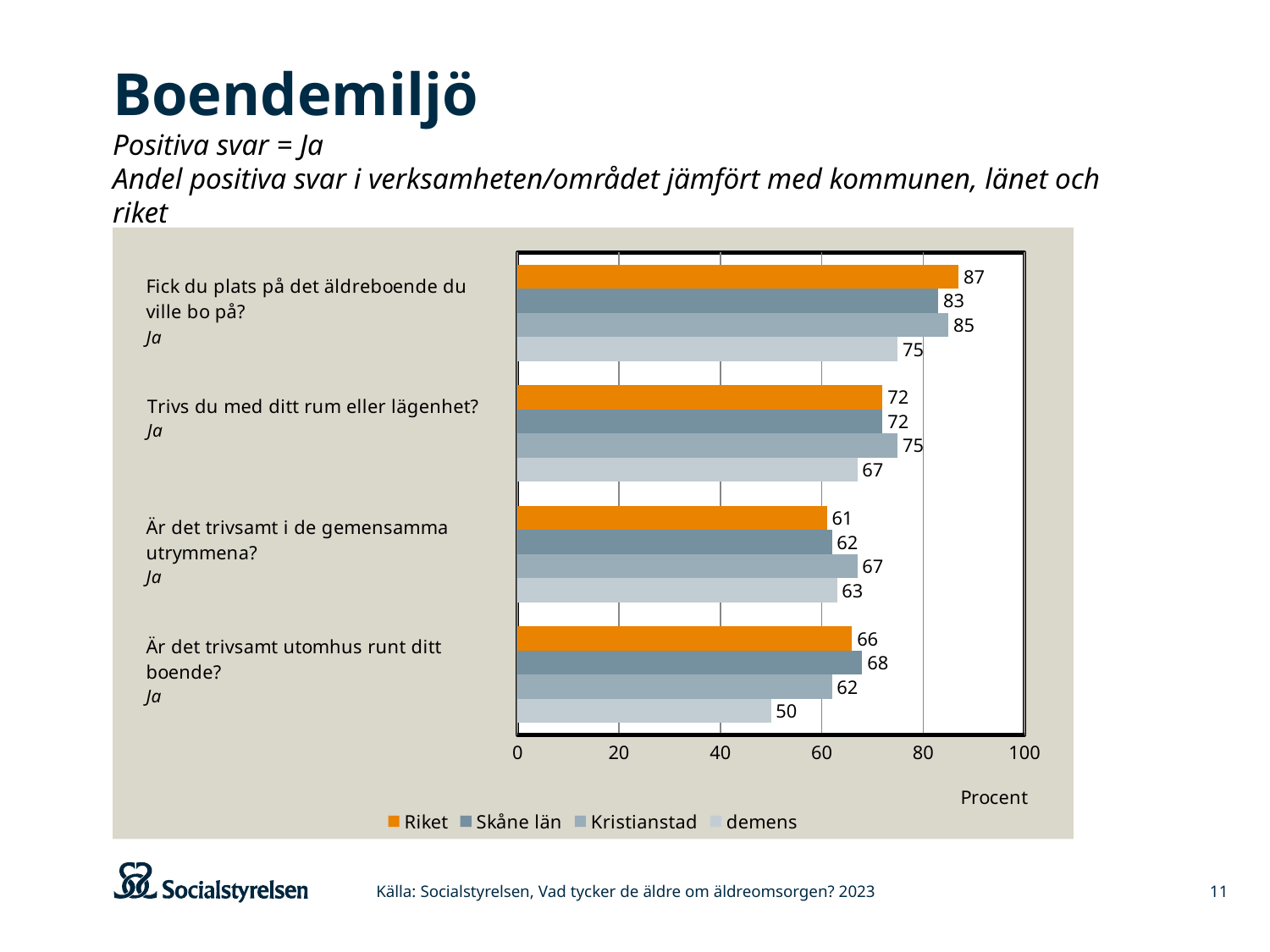
How many series does the legend list? 4 What is the value for demens on "Är det trivsamt utomhus runt ditt boende?"? 50 What is the difference between the Riket and demens values on "Fick du plats på det äldreboende du ville bo på?"? 12 What is the value for Kristianstad on "Trivs du med ditt rum eller lägenhet?"? 75 What unit is shown on the horizontal axis of the chart? Procent Which series has the highest value on "Är det trivsamt i de gemensamma utrymmena?"? Kristianstad How many question categories are shown in the chart? 4 Which series has the lowest value on "Är det trivsamt utomhus runt ditt boende?"? demens What is the value for Skåne län on "Är det trivsamt i de gemensamma utrymmena?"? 62 Which is larger on "Är det trivsamt utomhus runt ditt boende?": Skåne län or Kristianstad? Skåne län What is the value for Riket on "Fick du plats på det äldreboende du ville bo på?"? 87 What kind of chart is shown on the slide? Bar chart